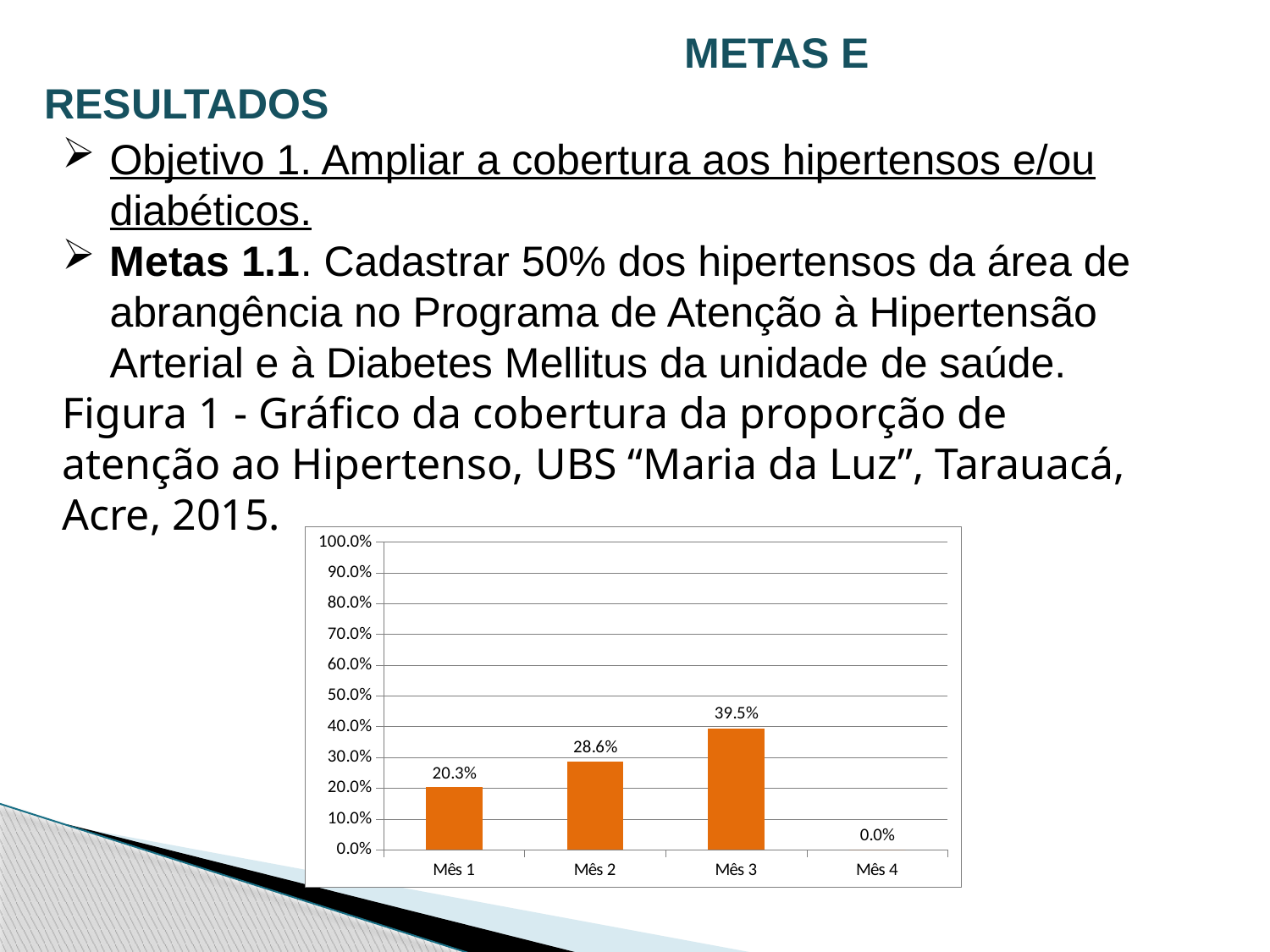
Is the value for Mês 3 greater or less than 50.0%? less Which month has the highest value? Mês 3 What is the value for Mês 4? 0.0% What is the difference between the values for Mês 3 and Mês 1? 19.2% Do the values rise or fall from Mês 1 to Mês 3? rise Which month has the lowest value? Mês 4 What is the value for Mês 2? 28.6% What is the value for Mês 3? 39.5% What kind of chart is shown? bar chart Which is larger, the value for Mês 2 or the value for Mês 1? Mês 2 What is the value for Mês 1? 20.3% How many months are shown on the x axis? 4